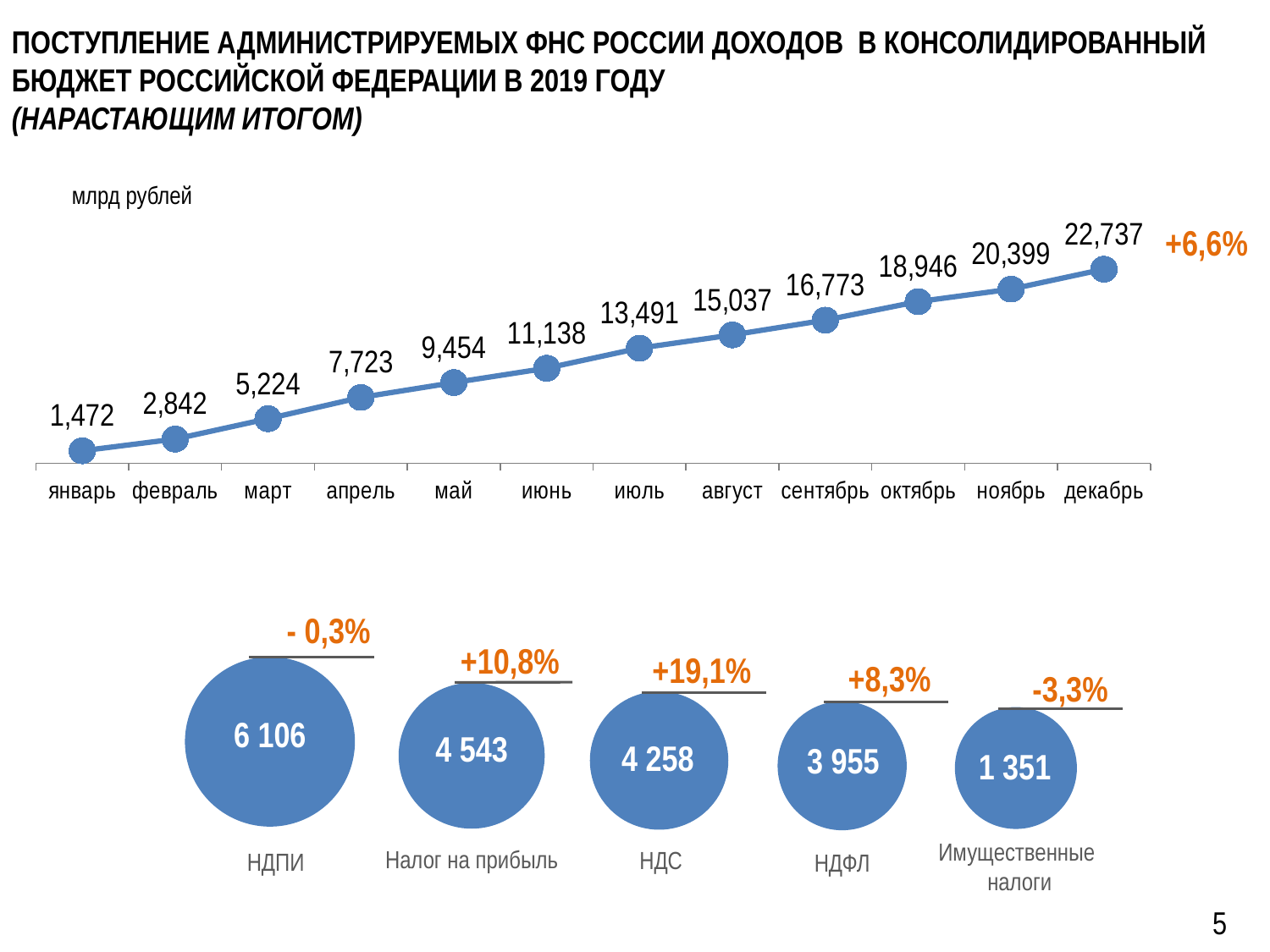
In the bottom bubble chart, what is the difference between the values for НДПИ and Имущественные налоги? 4 755 In the top line chart, what is the value for июнь? 11,138 In the top line chart, what is the difference between the values for декабрь and январь? 21,265 In the top line chart, what is the value for декабрь? 22,737 In the top line chart, what percentage change is shown next to the декабрь value? +6,6% In the top line chart, which month has the lowest value? январь In the bottom bubble chart, what is the value for НДС? 4 258 In the top line chart, do the values rise or fall from январь to декабрь? rise In the bottom bubble chart, what percentage change is shown above Налог на прибыль? +10,8% In the top line chart, how many months are plotted? 12 In the bottom bubble chart, which category has the highest value? НДПИ What type of chart is the top chart on the slide? line chart